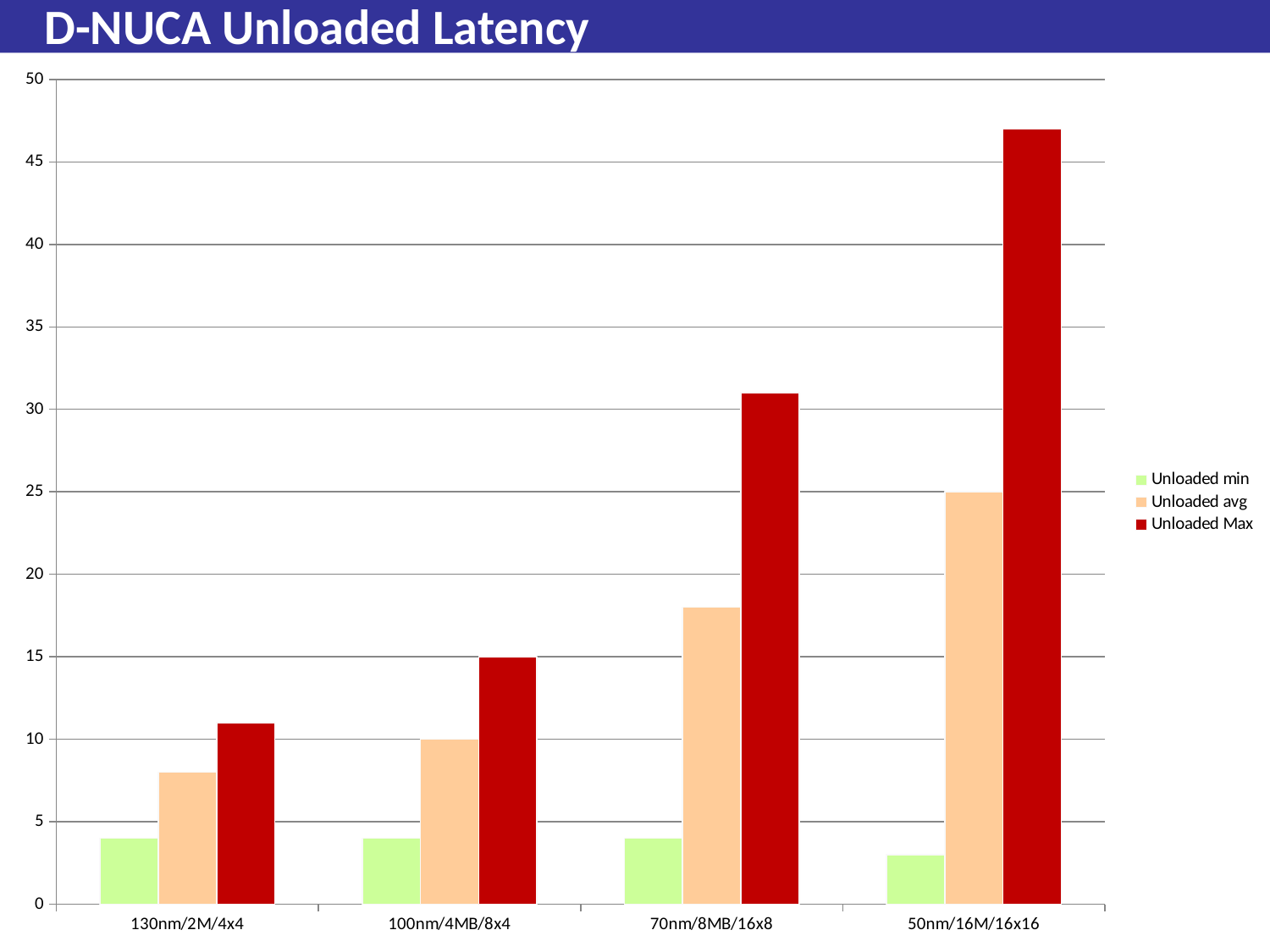
Which category has the lowest Unloaded avg value? 130nm/2M/4x4 Is the Unloaded Max value for 70nm/8MB/16x8 greater or less than 30? greater Do the Unloaded Max values rise or fall from left to right across the categories? rise How many series does the legend list? 3 What kind of chart is shown on the slide? bar chart What is the title of the chart? D-NUCA Unloaded Latency Is the Unloaded avg value for 70nm/8MB/16x8 greater or less than 20? less Which category has the highest Unloaded Max value? 50nm/16M/16x16 Is the Unloaded Max value for 50nm/16M/16x16 greater or less than 45? greater Which is larger, the Unloaded avg value for 70nm/8MB/16x8 or for 130nm/2M/4x4? 70nm/8MB/16x8 How many categories are shown on the x axis? 4